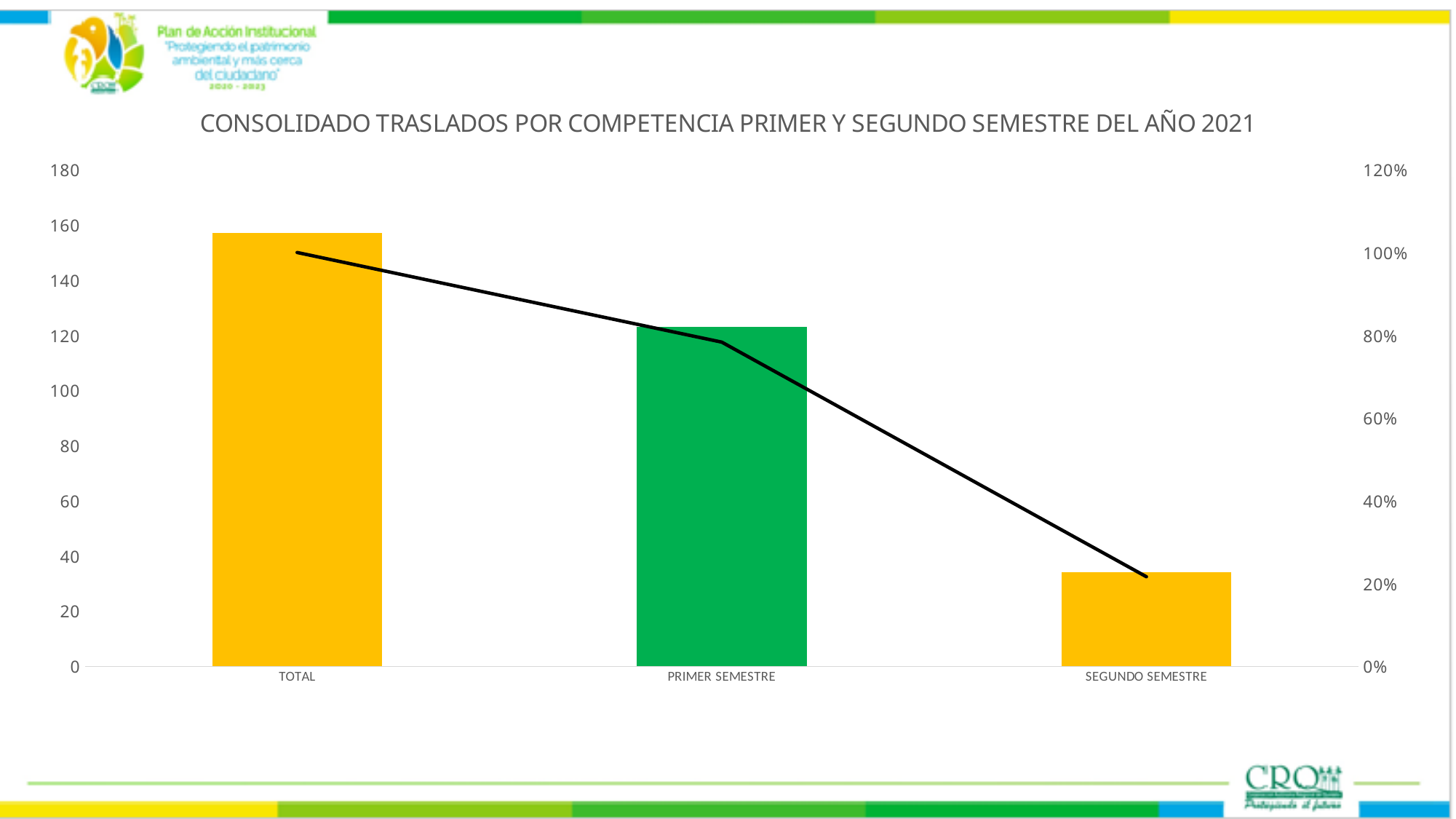
Which category has the tallest bar? TOTAL Is the line value for SEGUNDO SEMESTRE on the right axis greater or less than 40%? less Is the bar value for TOTAL greater or less than 140? greater Is the bar value for SEGUNDO SEMESTRE greater or less than 40? less Which bar is taller, PRIMER SEMESTRE or SEGUNDO SEMESTRE? PRIMER SEMESTRE What kind of chart is shown on the slide? Bar chart with a line overlay How many categories are shown on the x axis? 3 What colour is the PRIMER SEMESTRE bar? Green Which category has the shortest bar? SEGUNDO SEMESTRE Do the bar values rise or fall from left to right across the categories? fall What is the title of the chart? CONSOLIDADO TRASLADOS POR COMPETENCIA PRIMER Y SEGUNDO SEMESTRE DEL AÑO 2021